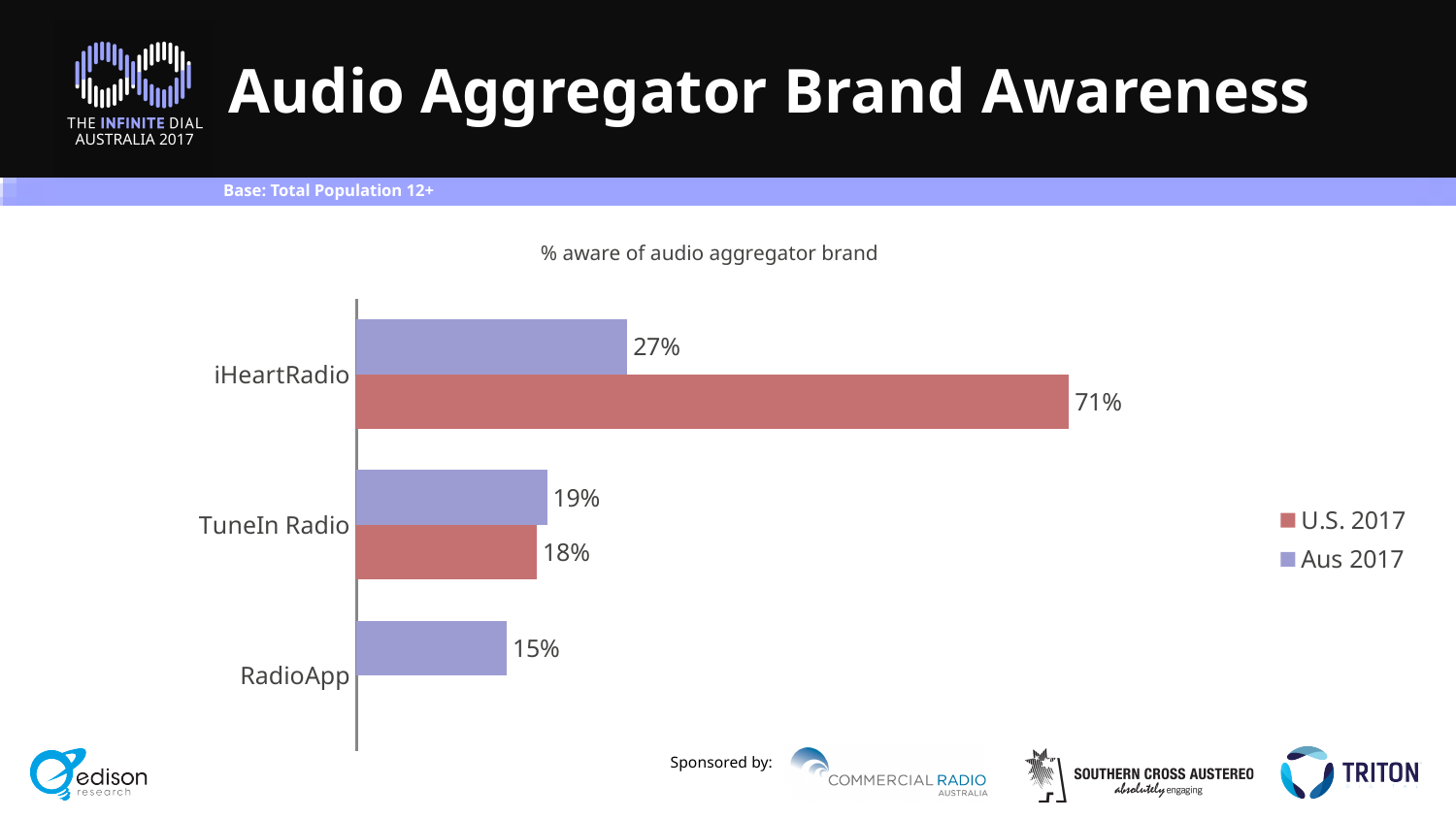
What kind of chart is shown on the slide? Bar chart How many series does the legend list? 2 What is the Aus 2017 awareness value for TuneIn Radio? 19% What is the Aus 2017 awareness value for iHeartRadio? 27% What is the Aus 2017 awareness value for RadioApp? 15% Which brand has the lowest Aus 2017 awareness? RadioApp Which is larger for TuneIn Radio: the U.S. 2017 value or the Aus 2017 value? Aus 2017 How many brands are shown on the chart? 3 What is the U.S. 2017 awareness value for TuneIn Radio? 18% What is the U.S. 2017 awareness value for iHeartRadio? 71% What is the difference between the U.S. 2017 and Aus 2017 awareness values for iHeartRadio? 44% Which brand has the highest U.S. 2017 awareness? iHeartRadio